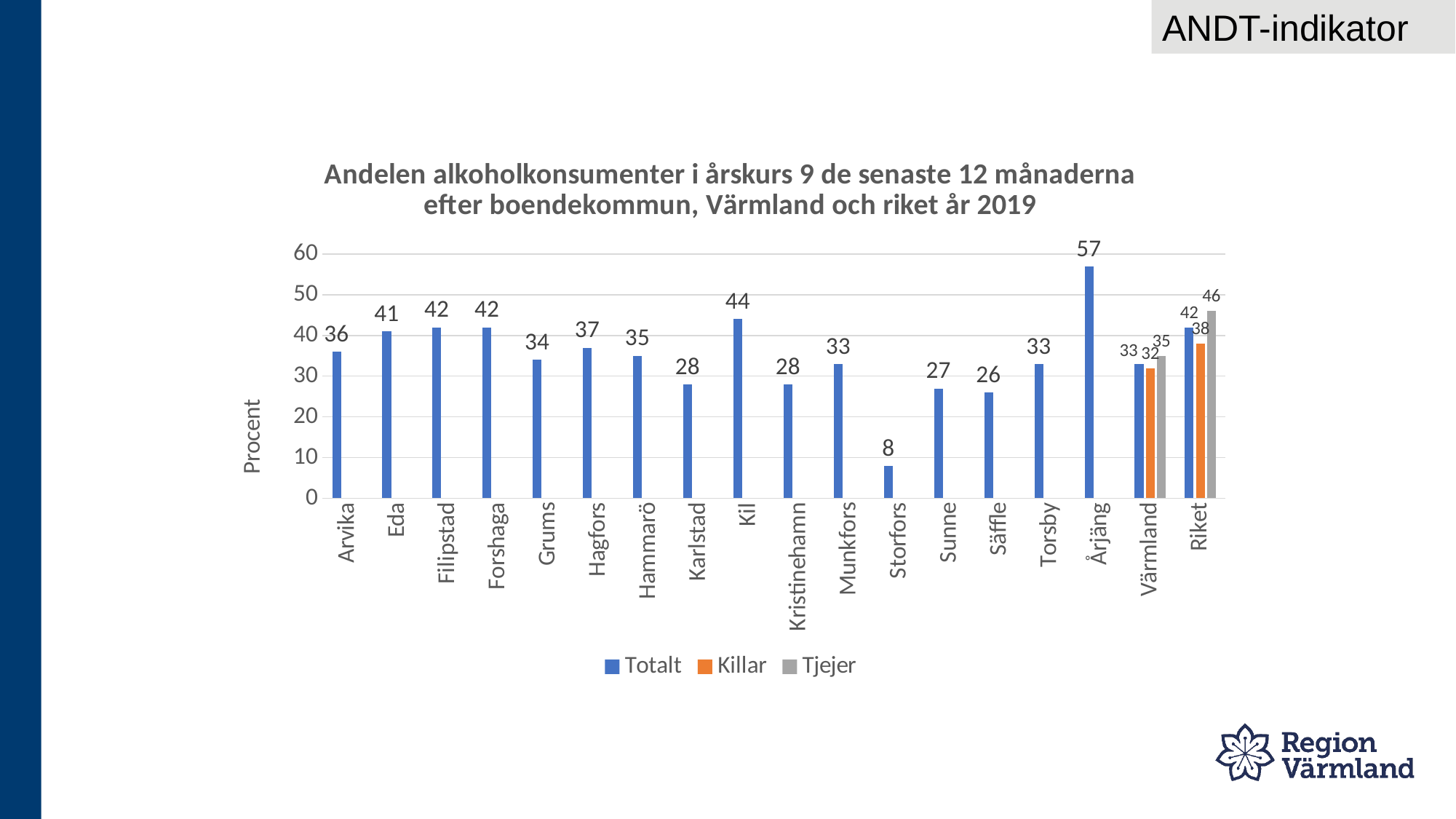
Which category has the lowest Totalt value? Storfors What is the Tjejer value for Värmland? 35 How many series does the legend list? 3 What is the Totalt value for Kil? 44 What kind of chart is shown on the slide? Bar chart What is the Killar value for Riket? 38 Which category has the highest Totalt value? Årjäng What is the label of the y axis? Procent Which has a higher Totalt value, Eda or Grums? Eda How many categories are shown on the x axis? 18 What is the difference between the Totalt values for Årjäng and Storfors? 49 What is the difference between the Tjejer and Killar values for Riket? 8